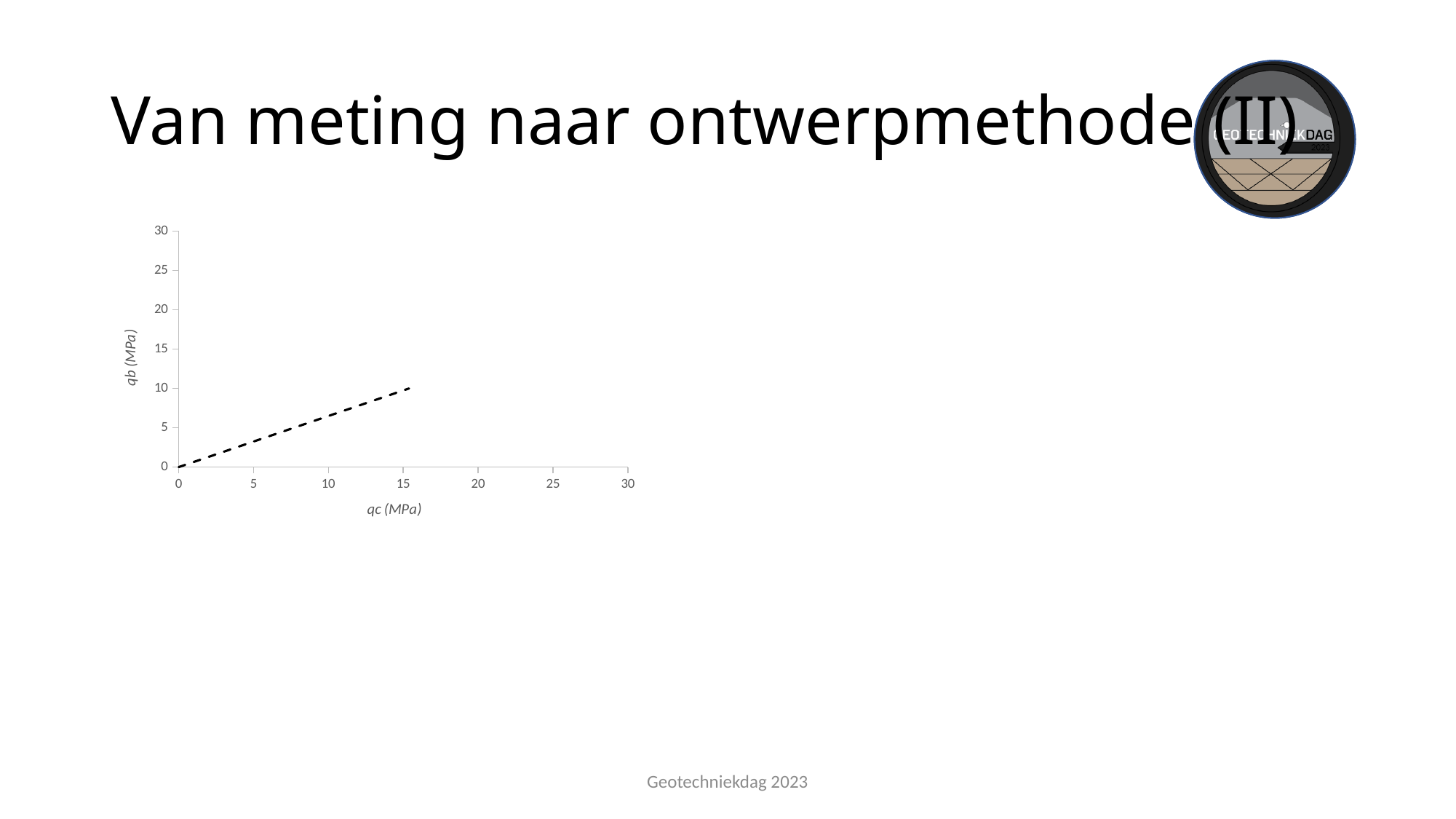
Is the value of qb at qc = 15 greater or less than 15? less Is the value of qb at qc = 10 greater or less than 10? less What kind of chart is shown on the slide? line chart How many lines are plotted on the chart? 1 Is the value of qb at qc = 5 greater or less than 5? less What is the label of the y axis of the chart? qb (MPa) Does the dashed line rise or fall as qc increases? rise What is the label of the x axis of the chart? qc (MPa) What is the highest tick value shown on the x axis? 30